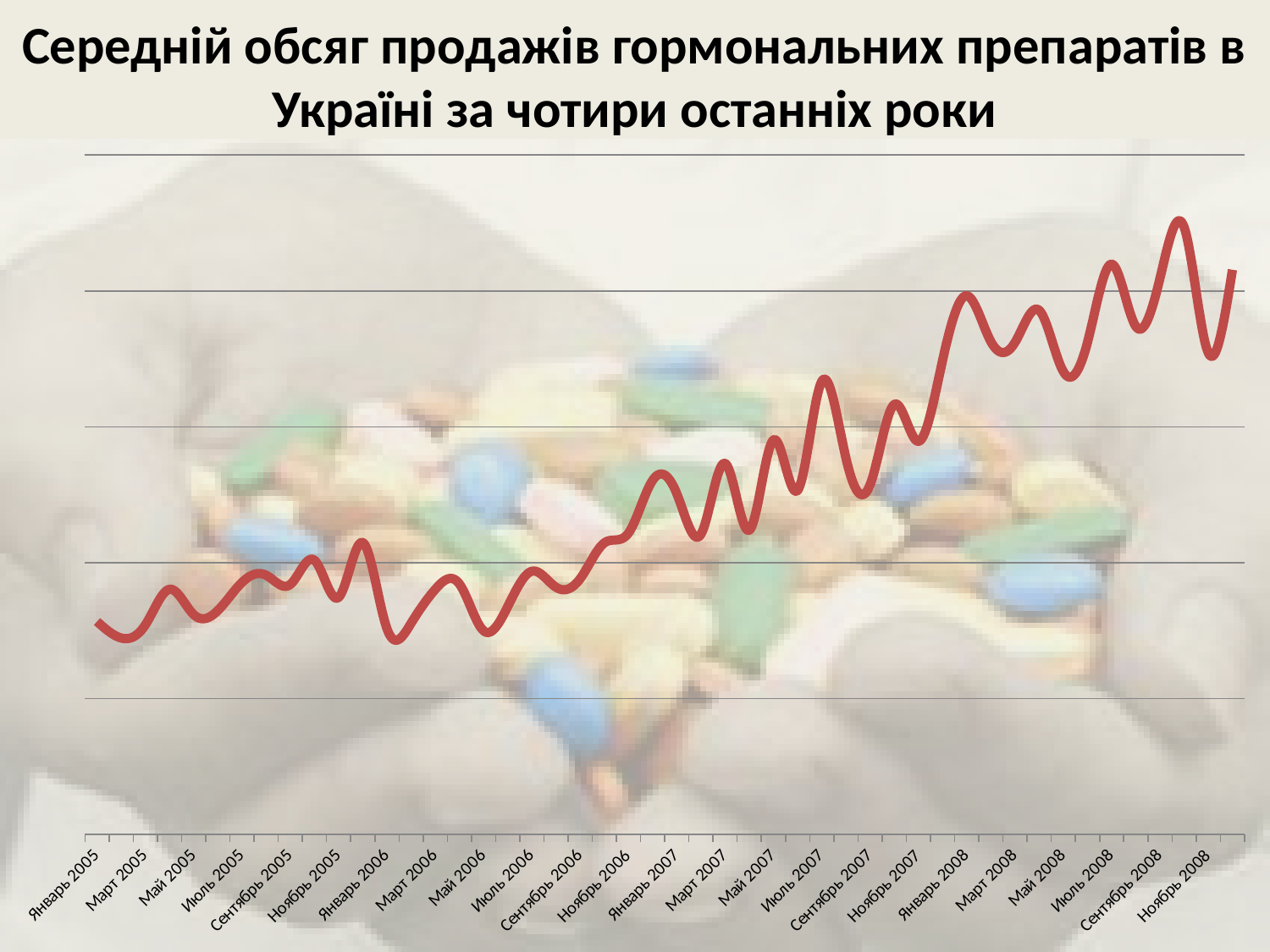
What kind of chart is shown on the slide? line chart How many month labels are shown along the x axis? 24 What colour is the plotted line? red What is the title of the chart on the slide? Середній обсяг продажів гормональних препаратів в Україні за чотири останніх роки Which is larger, the value at Январь 2008 or the value at Январь 2006? Январь 2008 Overall, do the values rise or fall from Январь 2005 to Ноябрь 2008? rise What is the last month label on the x axis? Ноябрь 2008 What is the first month label on the x axis? Январь 2005 Which is larger, the value at Ноябрь 2008 or the value at Январь 2005? Ноябрь 2008 How many lines are plotted on the chart? 1 In which year does the line reach its highest point? 2008